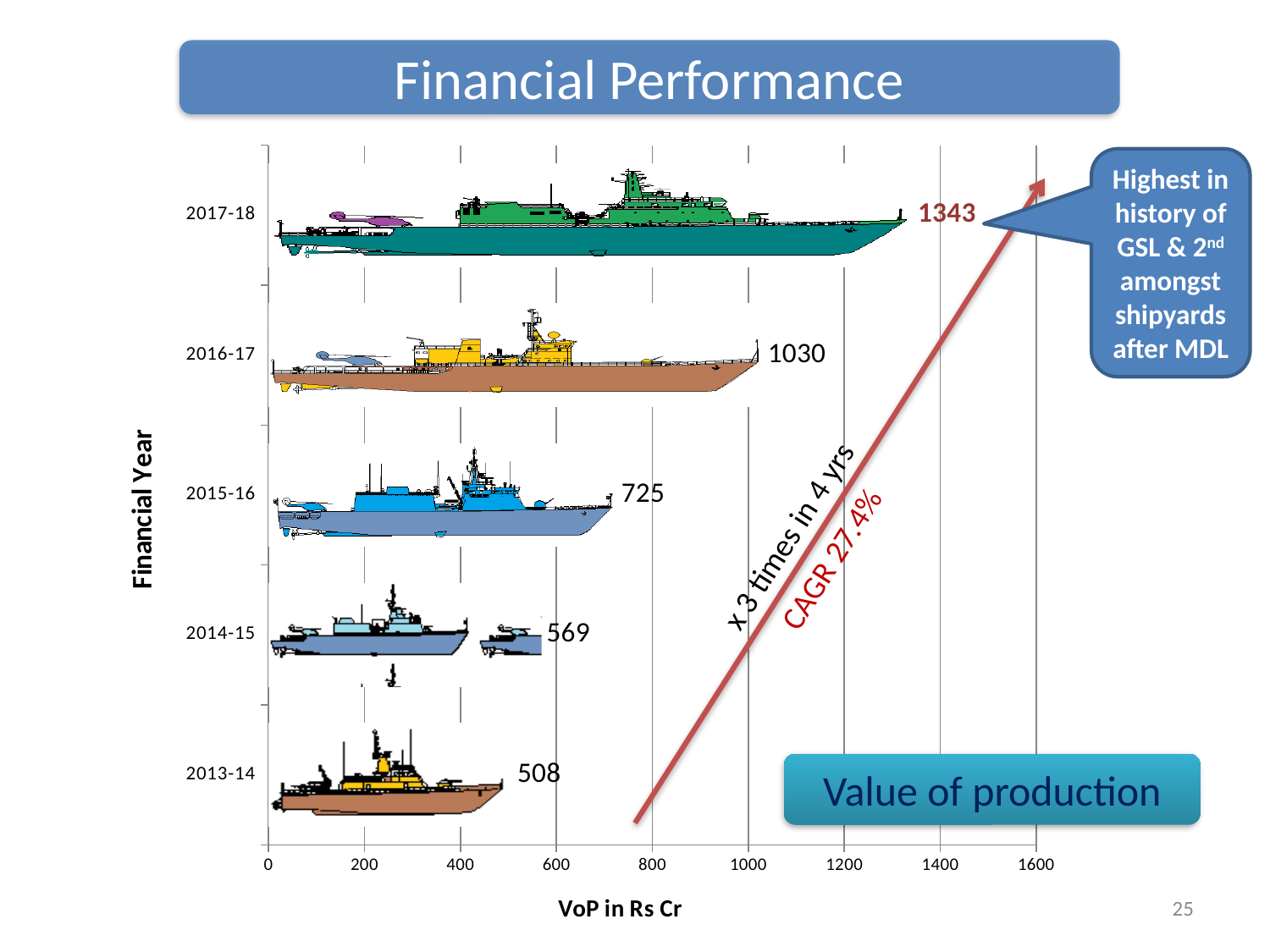
What is the difference in value of production between 2014-15 and 2013-14? 61 Is the value of production for 2016-17 greater or less than 1000? greater How many financial years are shown on the chart? 5 Which financial year has the lowest value of production? 2013-14 What is the value of production for 2017-18? 1343 What is the value of production for 2013-14? 508 Which financial year has the highest value of production? 2017-18 What is the difference in value of production between 2017-18 and 2016-17? 313 What is the label of the horizontal axis of the chart? VoP in Rs Cr Which is larger, the value of production for 2016-17 or for 2015-16? 2016-17 What is the value of production for 2015-16? 725 What kind of chart is shown on the slide? bar chart